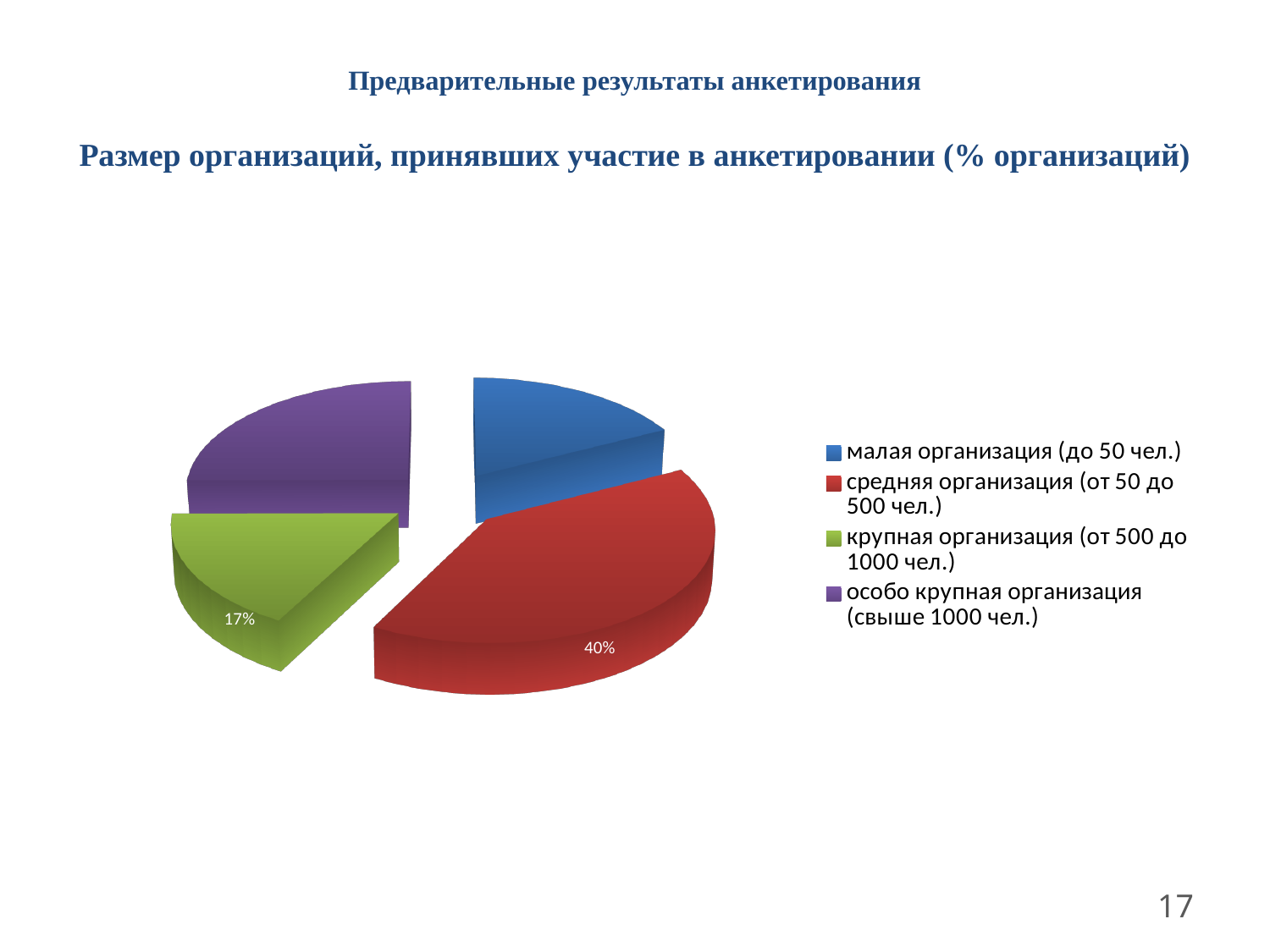
What is the difference in percentage points between the slices for средняя организация and крупная организация? 23 Which category has the largest slice of the pie? средняя организация (от 50 до 500 чел.) What kind of chart is shown on the slide? pie chart What colour is the slice for малая организация (до 50 чел.)? blue What share of organisations is shown for средняя организация (от 50 до 500 чел.)? 40% What is the title of the chart? Размер организаций, принявших участие в анкетировании (% организаций) What share of organisations is shown for крупная организация (от 500 до 1000 чел.)? 17% Which is larger: the slice for средняя организация or the slice for особо крупная организация? средняя организация Which is larger: the slice for средняя организация or the slice for крупная организация? средняя организация How many slices does the pie chart have? 4 How many entries does the legend list? 4